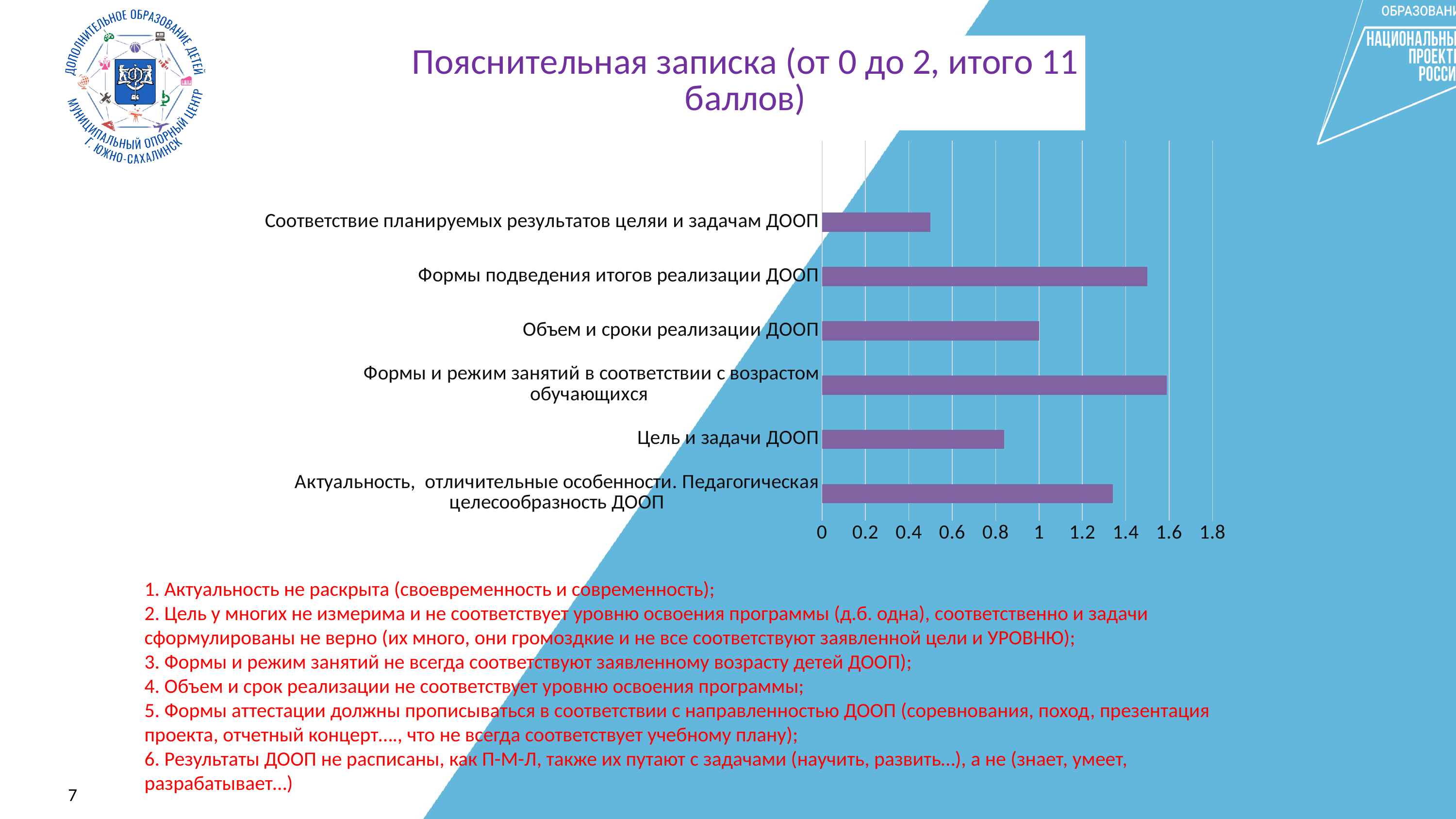
Is the value for Актуальность, отличительные особенности. Педагогическая целесообразность ДООП greater or less than 1.2? greater Which category has the lowest value in the chart? Соответствие планируемых результатов целяи и задачам ДООП What is the title of the slide containing the chart? Пояснительная записка (от 0 до 2, итого 11 баллов) Is the value for Цель и задачи ДООП greater or less than 1? less Is the value for Формы подведения итогов реализации ДООП greater or less than 1.4? greater Which is larger: the value for Формы подведения итогов реализации ДООП or the value for Объем и сроки реализации ДООП? Формы подведения итогов реализации ДООП What kind of chart is shown on the slide? bar chart Which category has the highest value in the chart? Формы и режим занятий в соответствии с возрастом обучающихся What is the value for Объем и сроки реализации ДООП? 1 How many categories are plotted in the chart? 6 Which is larger: the value for Актуальность, отличительные особенности. Педагогическая целесообразность ДООП or the value for Цель и задачи ДООП? Актуальность, отличительные особенности. Педагогическая целесообразность ДООП